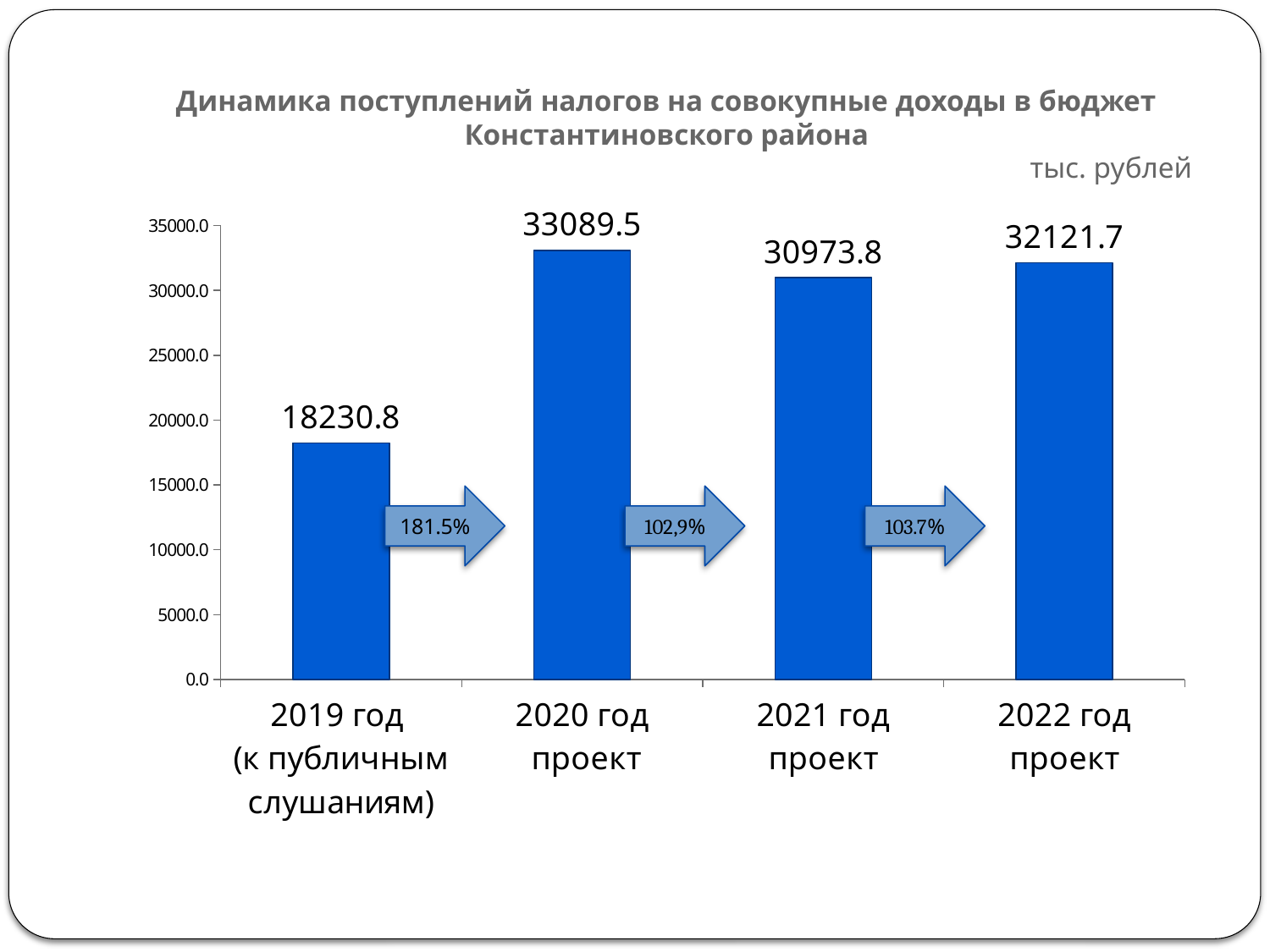
Which is larger, the value for 2021 год проект or 2022 год проект? 2022 год проект What kind of chart is shown on the slide? Bar chart What is the difference between the values for 2022 год проект and 2021 год проект? 1147.9 What unit is indicated above the chart? тыс. рублей How many bars are shown in the chart? 4 What is the value for 2019 год (к публичным слушаниям)? 18230.8 Which year has the highest value? 2020 год проект What is the value for 2021 год проект? 30973.8 What is the value for 2020 год проект? 33089.5 What is the difference between the values for 2020 год проект and 2019 год (к публичным слушаниям)? 14858.7 What is the value for 2022 год проект? 32121.7 Which year has the lowest value? 2019 год (к публичным слушаниям)